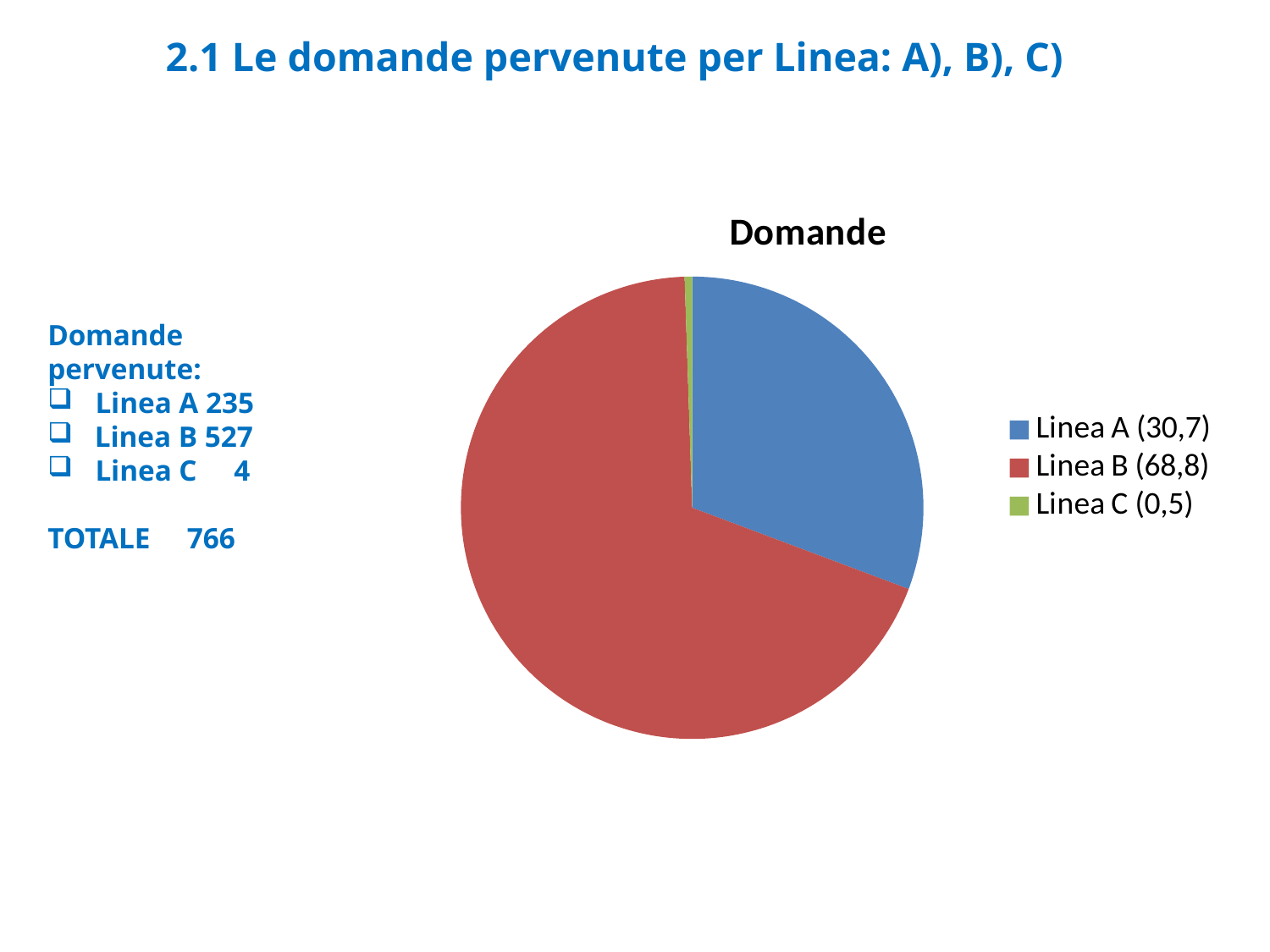
What kind of chart is shown on the slide? pie chart Which Linea has the largest slice of the pie chart? Linea B How many slices does the pie chart have? 3 Which Linea has the smallest slice of the pie chart? Linea C How many entries does the legend of the pie chart list? 3 What colour is the Linea B slice in the pie chart? red Which slice is larger in the pie chart, Linea A or Linea B? Linea B What is the title of the pie chart? Domande What is the difference between the legend shares of Linea B and Linea A? 38,1 What share of the pie does Linea B represent, according to the legend? 68,8 What share of the pie does Linea C represent, according to the legend? 0,5 What share of the pie does Linea A represent, according to the legend? 30,7